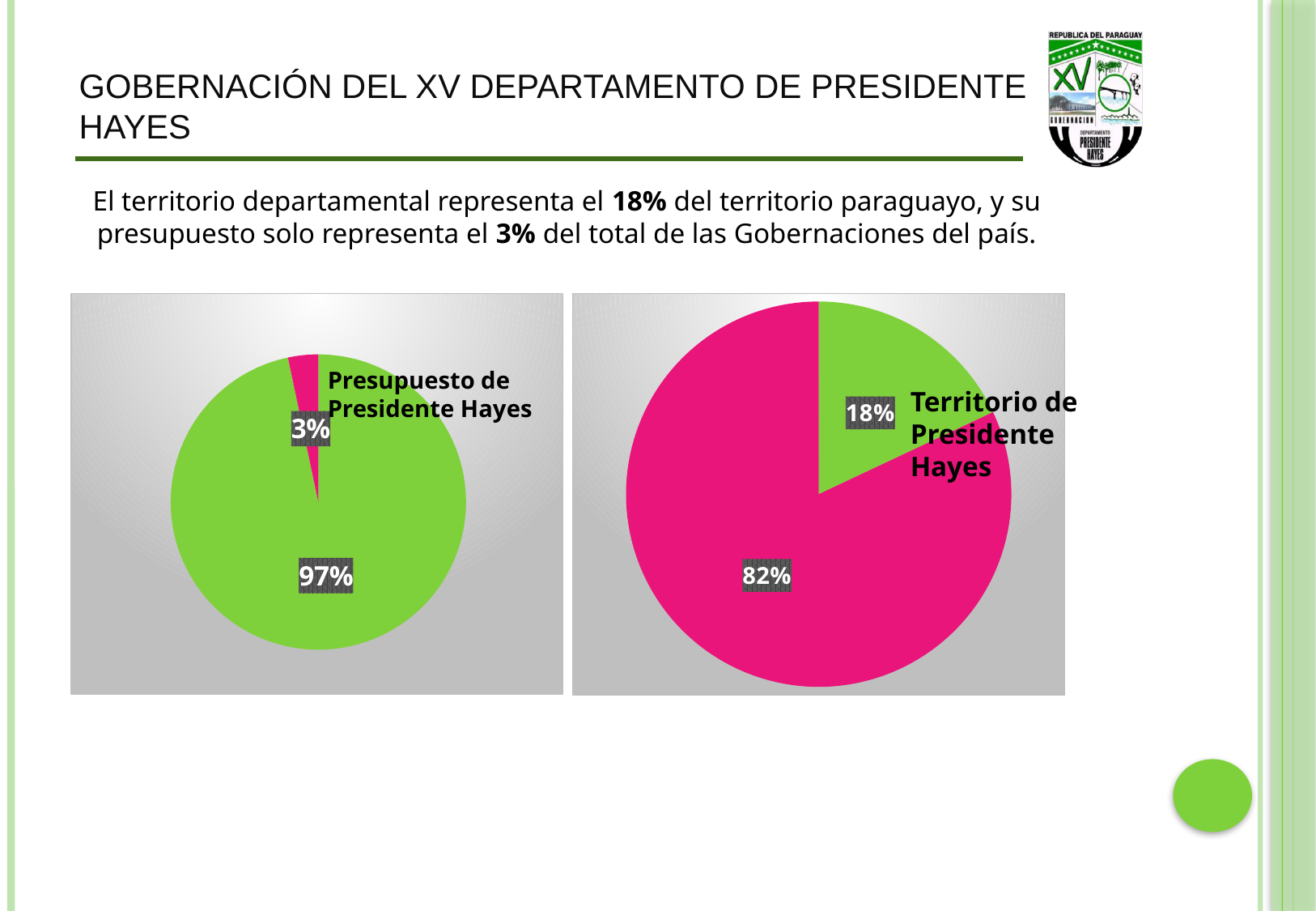
In the left pie chart, what is the difference between the two slices? 94% In the right pie chart, what share is labelled 'Territorio de Presidente Hayes'? 18% How many slices does the right pie chart have? 2 In the left pie chart, what is the value of the larger green slice? 97% In the right pie chart, what is the difference between the two slices? 64% In the left pie chart, what share is labelled 'Presupuesto de Presidente Hayes'? 3% In the right pie chart, which slice is the smallest? Territorio de Presidente Hayes In the right pie chart, what is the value of the larger pink slice? 82% What colour is the 'Presupuesto de Presidente Hayes' slice in the left pie chart? pink Which is larger: the 'Presupuesto de Presidente Hayes' slice in the left chart or the 'Territorio de Presidente Hayes' slice in the right chart? Territorio de Presidente Hayes What kind of chart is the left chart on the slide? pie chart How many slices does the left pie chart have? 2